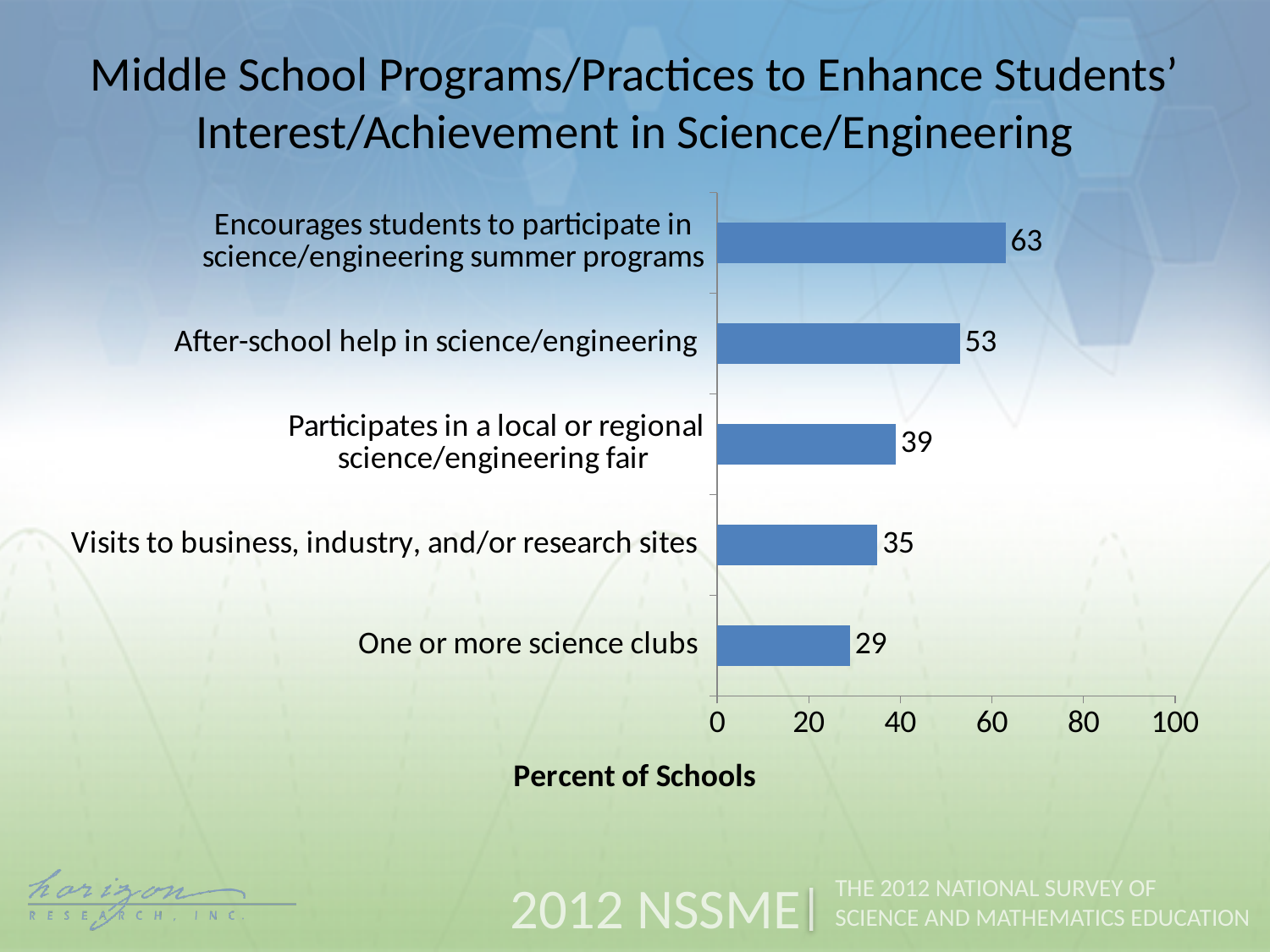
Which is larger: the value for 'Visits to business, industry, and/or research sites' or 'Participates in a local or regional science/engineering fair'? Participates in a local or regional science/engineering fair Which program/practice has the lowest percent of schools? One or more science clubs How many programs/practices are shown in the chart? 5 Is the value for 'Visits to business, industry, and/or research sites' greater or less than 40? less What is the value for 'One or more science clubs'? 29 What is the label of the horizontal axis? Percent of Schools What percent of schools encourage students to participate in science/engineering summer programs? 63 Which program/practice has the highest percent of schools? Encourages students to participate in science/engineering summer programs What kind of chart is shown on the slide? Bar chart What is the value for 'After-school help in science/engineering'? 53 What percent of schools participate in a local or regional science/engineering fair? 39 What is the difference between the values for 'After-school help in science/engineering' and 'One or more science clubs'? 24